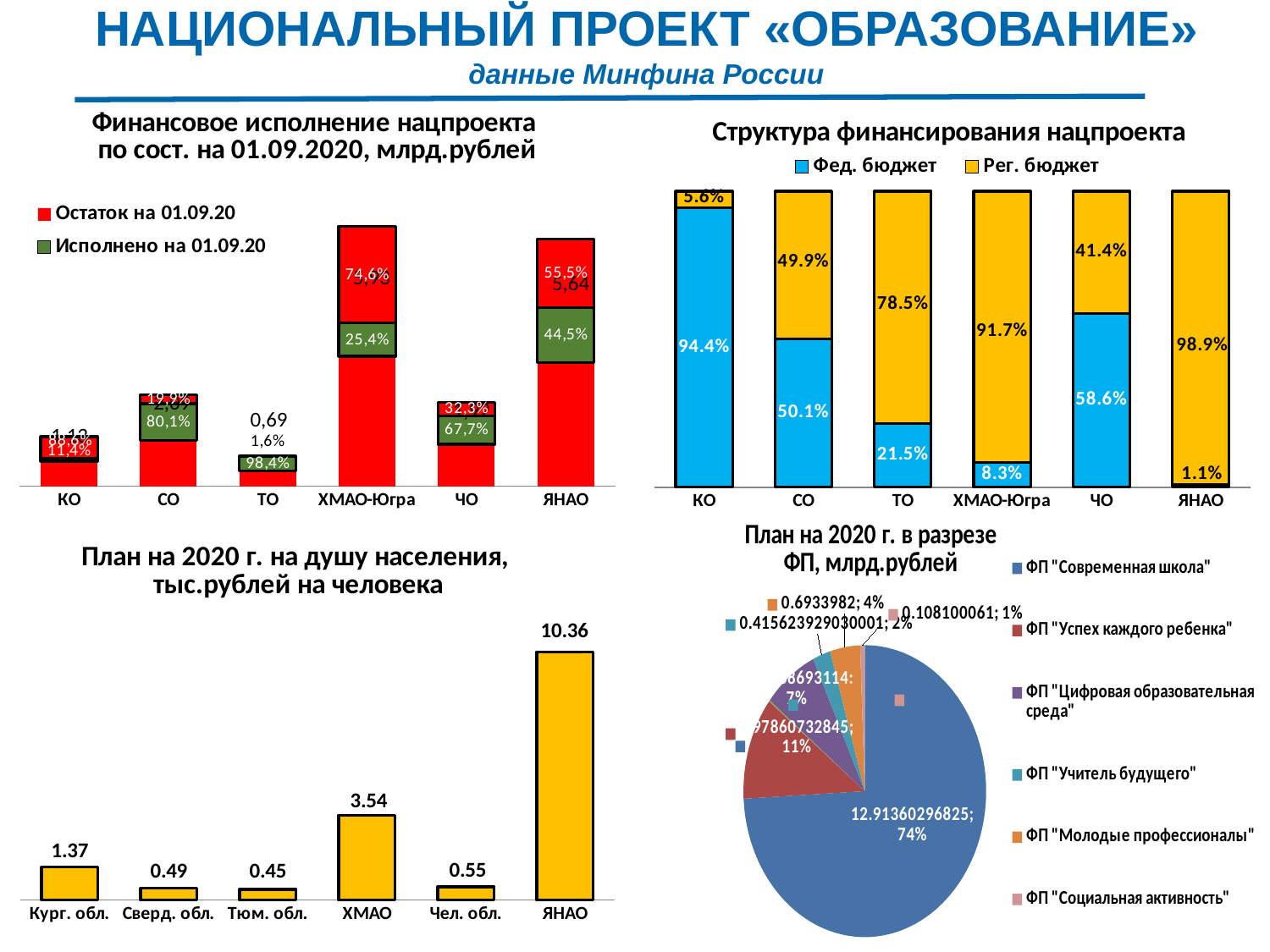
In the chart 'Финансовое исполнение нацпроекта по сост. на 01.09.2020, млрд.рублей', what is the total value shown above the ЯНАО bar? 5,64 In the pie chart 'План на 2020 г. в разрезе ФП, млрд.рублей', what share does ФП "Современная школа" have? 74% In the chart 'Структура финансирования нацпроекта', which is larger for ЧО: Фед. бюджет or Рег. бюджет? Фед. бюджет In the chart 'План на 2020 г. на душу населения, тыс.рублей на человека', what is the difference between ХМАО and Кург. обл.? 2.17 In the chart 'План на 2020 г. на душу населения, тыс.рублей на человека', how many regions are shown? 6 In the chart 'Структура финансирования нацпроекта', how many series does the legend list? 2 What kind of chart is 'План на 2020 г. в разрезе ФП, млрд.рублей'? pie chart In the chart 'План на 2020 г. на душу населения, тыс.рублей на человека', which region has the lowest value? Тюм. обл. In the chart 'Финансовое исполнение нацпроекта по сост. на 01.09.2020, млрд.рублей', what percentage is labelled 'Исполнено на 01.09.20' for ХМАО-Югра? 25,4% In the chart 'Структура финансирования нацпроекта', what is the share of Фед. бюджет for ТО? 21.5% In the chart 'План на 2020 г. на душу населения, тыс.рублей на человека', what is the value for ЯНАО? 10.36 In the chart 'Структура финансирования нацпроекта', which region has the highest share of Рег. бюджет? ЯНАО